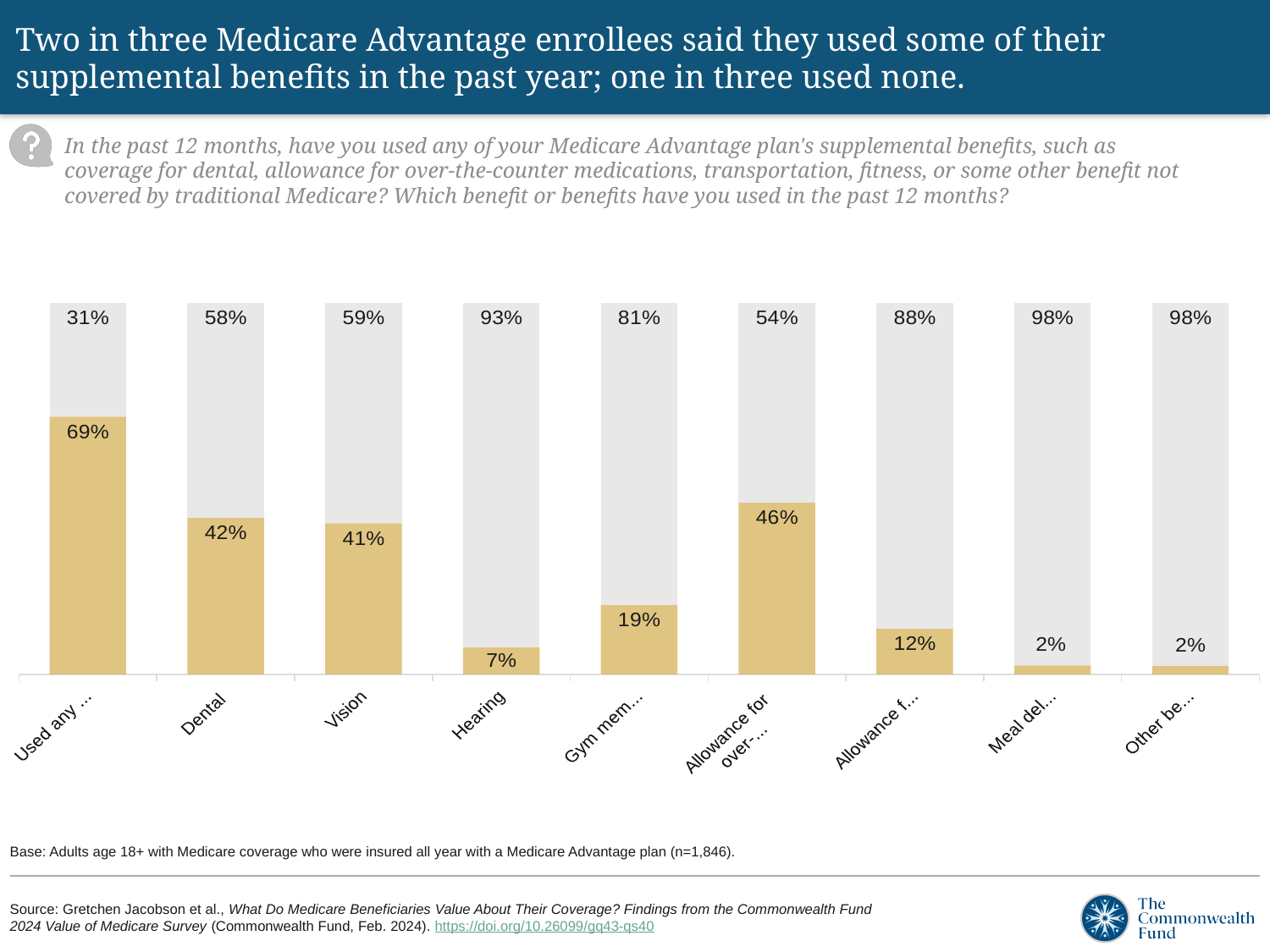
What is the value of the grey segment for Hearing? 93% What is the value of the gold segment for Hearing? 7% What is the value of the grey segment for Vision? 59% What kind of chart is shown on the slide? Stacked bar chart Among Dental, Vision and Hearing, which has the lowest gold-segment value? Hearing Which has a larger gold segment, Dental or Hearing? Dental What is the value of the gold segment for Dental? 42% What is the difference between the grey and gold segments of the Dental bar? 16 percentage points What is the total of the Vision stacked bar? 100% What two colours are used for the bar segments? Gold and grey What is the highest gold-segment value shown on the chart? 69% How many bars (categories) are shown on the chart? 9